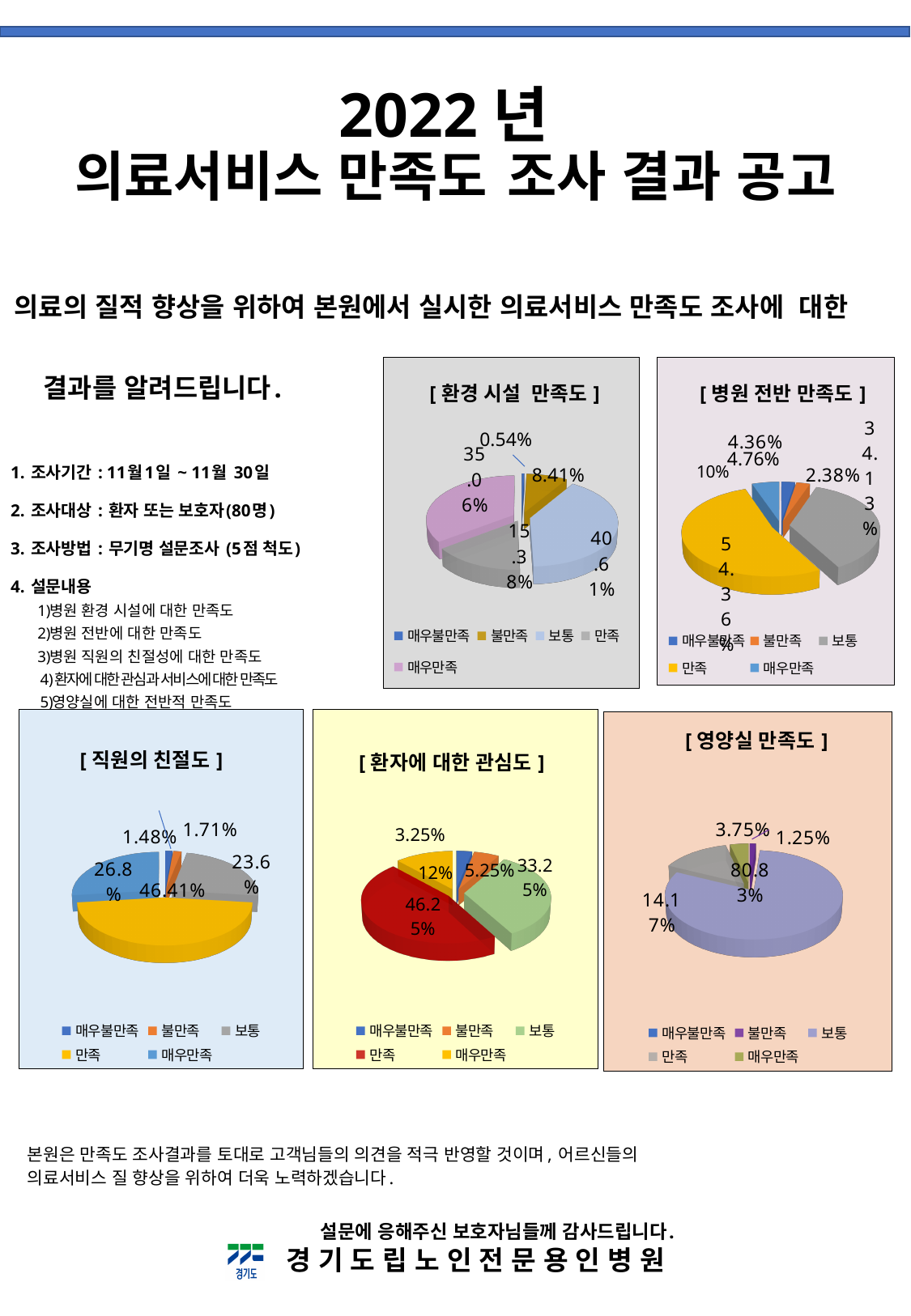
In the [환경 시설 만족도] chart, what is the value for 보통? 40.61% In the [병원 전반 만족도] chart, what is the value for 만족? 54.36% In the [환자에 대한 관심도] chart, what is the difference between 만족 (46.25%) and 보통 (33.25%)? 13% In the [직원의 친절도] chart, what is the value for 만족? 46.41% How many entries does the legend of the [환자에 대한 관심도] chart list? 5 In the [병원 전반 만족도] chart, what is the value for 불만족? 2.38% In the [환자에 대한 관심도] chart, what is the value for 매우만족? 12% In the [환경 시설 만족도] chart, what is the value for 불만족? 8.41% What kind of chart is used in the [환경 시설 만족도] chart? pie chart In the [환경 시설 만족도] chart, which category has the largest share? 보통 In the [영양실 만족도] chart, what is the value for 보통? 80.83% In the [직원의 친절도] chart, which category has the largest share? 만족